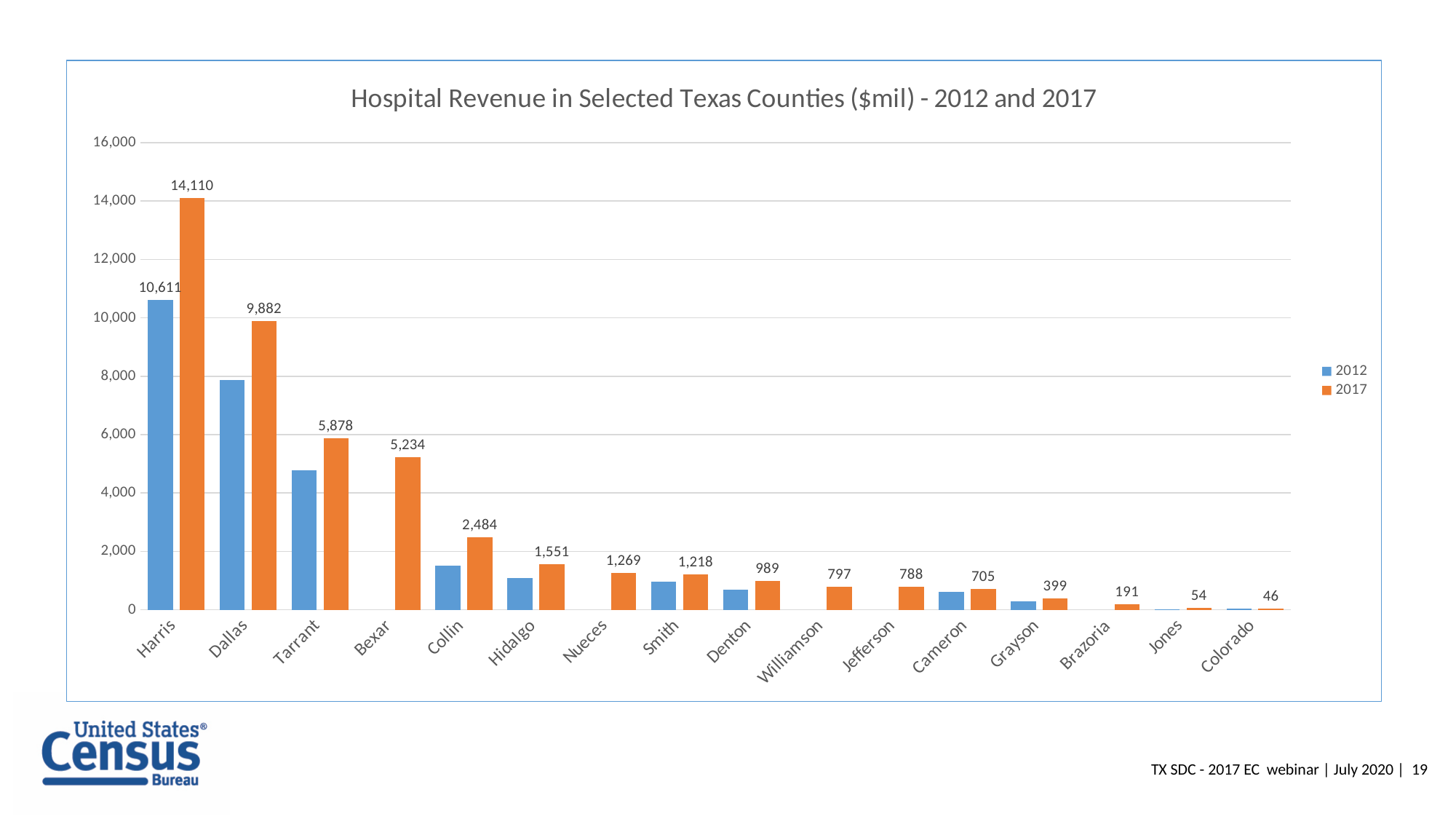
Which county has the lowest hospital revenue in 2017? Colorado How many counties are shown on the chart? 16 What is the difference between the 2017 hospital revenue of Collin County and Hidalgo County? 933 What is the 2017 hospital revenue for Dallas County? 9,882 What is the hospital revenue for Harris County in 2012? 10,611 Is the 2012 hospital revenue for Tarrant County greater or less than 4,000? greater Which county has the highest hospital revenue in 2017? Harris Which county had higher hospital revenue in 2017, Tarrant or Bexar? Tarrant By how much did Harris County's hospital revenue increase from 2012 to 2017? 3,499 How many series does the legend list? 2 What is the hospital revenue for Harris County in 2017? 14,110 What is the 2017 hospital revenue for Brazoria County? 191